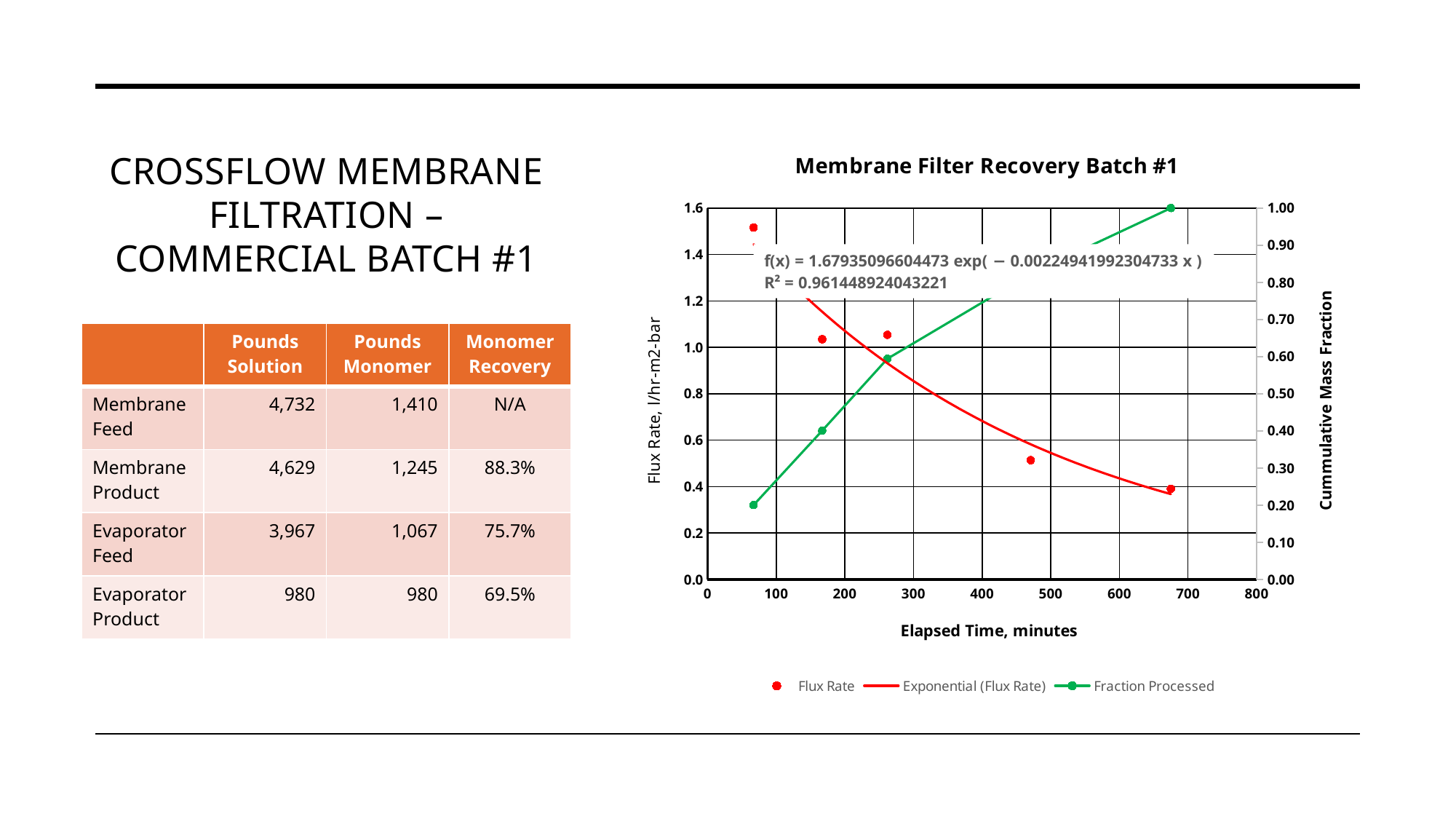
Is the last Flux Rate value (near 675 minutes) greater or less than 0.6? less What is the highest value reached by the Fraction Processed series on the right axis? 1.00 How many Flux Rate data points are plotted? 5 Do the Flux Rate values rise or fall as elapsed time increases? fall What R² value is printed on the chart for the exponential fit? 0.961448924043221 Is the first Flux Rate value (near 65 minutes) greater or less than 1.4? greater What type of chart is shown on the slide? scatter chart Is the Flux Rate value near 165 minutes larger or smaller than the Flux Rate value near 470 minutes? larger Do the Fraction Processed values rise or fall as elapsed time increases? rise How many series does the chart legend list? 3 What is the title of the chart? Membrane Filter Recovery Batch #1